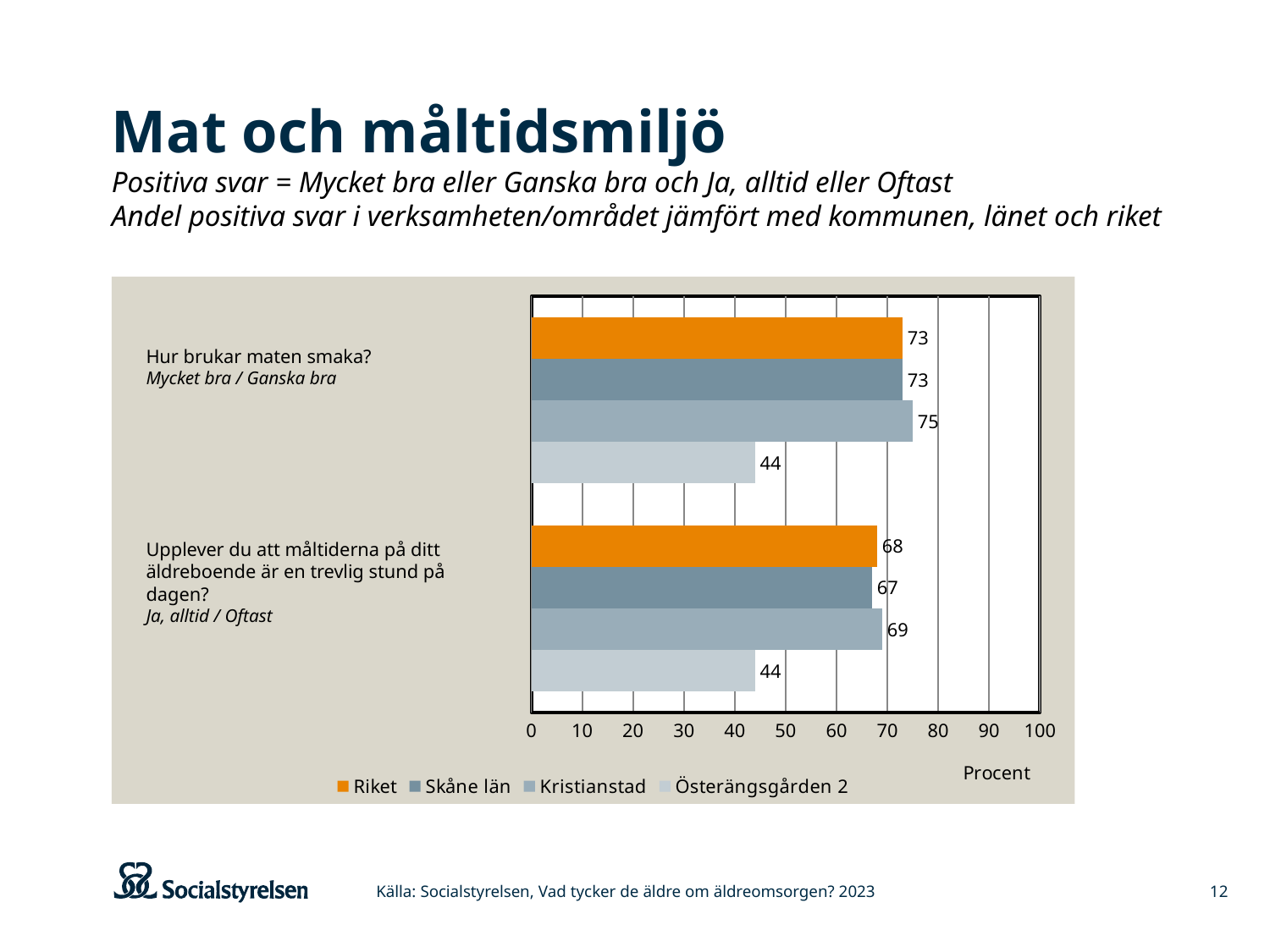
What unit label is shown below the x axis of the chart? Procent What value is shown for Riket on the question "Upplever du att måltiderna på ditt äldreboende är en trevlig stund på dagen?"? 68 What is the difference between the Riket value and the Skåne län value for the question "Upplever du att måltiderna på ditt äldreboende är en trevlig stund på dagen?"? 1 What value is shown for Kristianstad on the question "Hur brukar maten smaka?"? 75 Which is larger for the question "Upplever du att måltiderna på ditt äldreboende är en trevlig stund på dagen?": the Kristianstad value or the Österängsgården 2 value? Kristianstad Which series has the highest value for the question "Hur brukar maten smaka?"? Kristianstad What is the difference between the Kristianstad value and the Österängsgården 2 value for the question "Hur brukar maten smaka?"? 31 What value is shown for Österängsgården 2 on the question "Upplever du att måltiderna på ditt äldreboende är en trevlig stund på dagen?"? 44 Which series has the lowest value for the question "Upplever du att måltiderna på ditt äldreboende är en trevlig stund på dagen?"? Österängsgården 2 What kind of chart is shown on the slide? Bar chart What value is shown for Skåne län on the question "Hur brukar maten smaka?"? 73 How many series does the legend list? 4